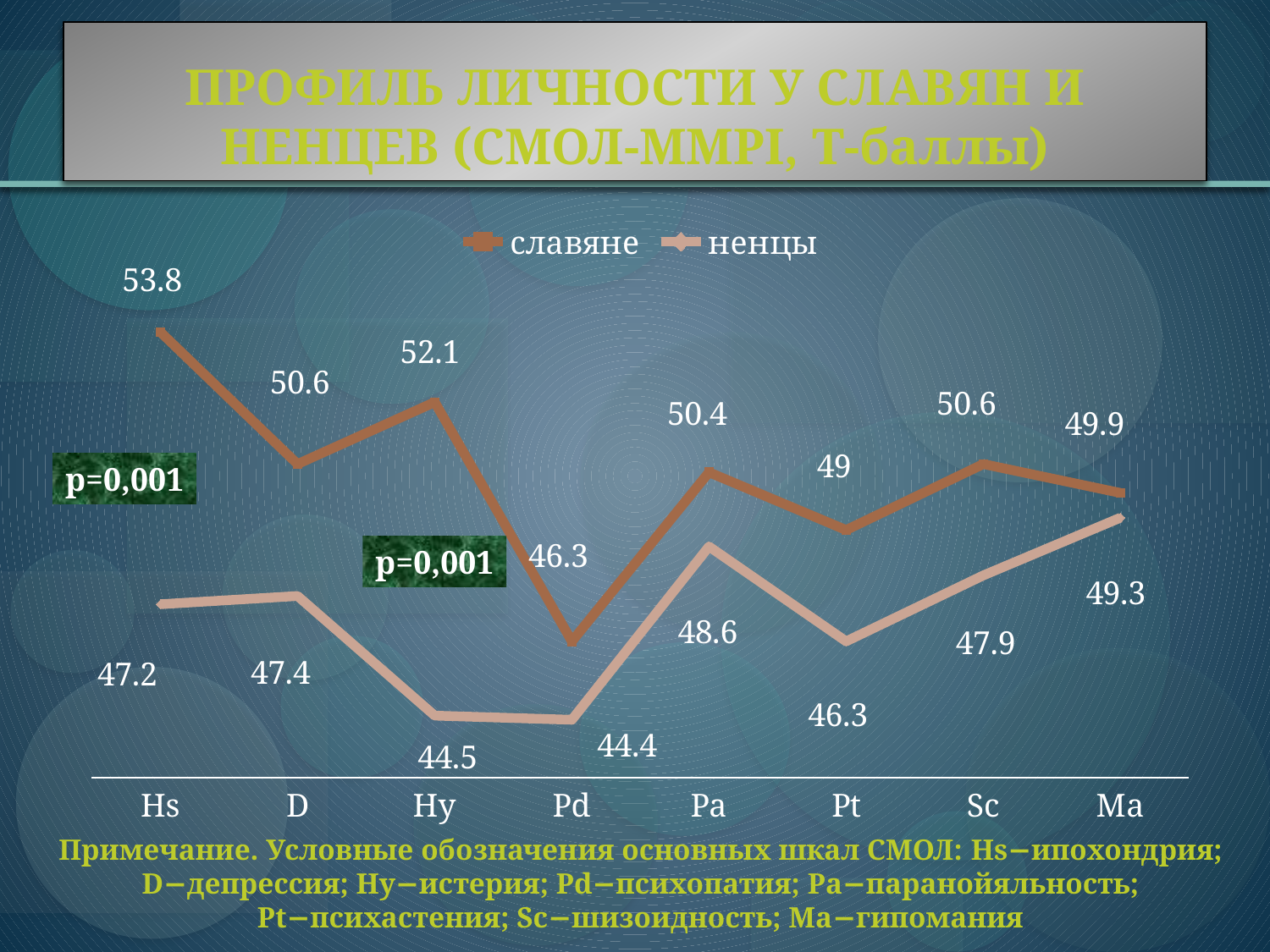
Which series is drawn in the darker brown line? славяне How many categories are shown on the x axis? 8 Which category has the lowest value for ненцы? Pd Which category has the highest value for славяне? Hs What type of chart is shown on the slide? line chart Which category has the lowest value for славяне? Pd What is the difference between славяне and ненцы at Hy? 7.6 What is the value for славяне at Pt? 49 What is the value for славяне at Hs? 53.8 Which is larger at Ma: the value for славяне or for ненцы? славяне What is the value for ненцы at Pd? 44.4 How many series does the legend list? 2